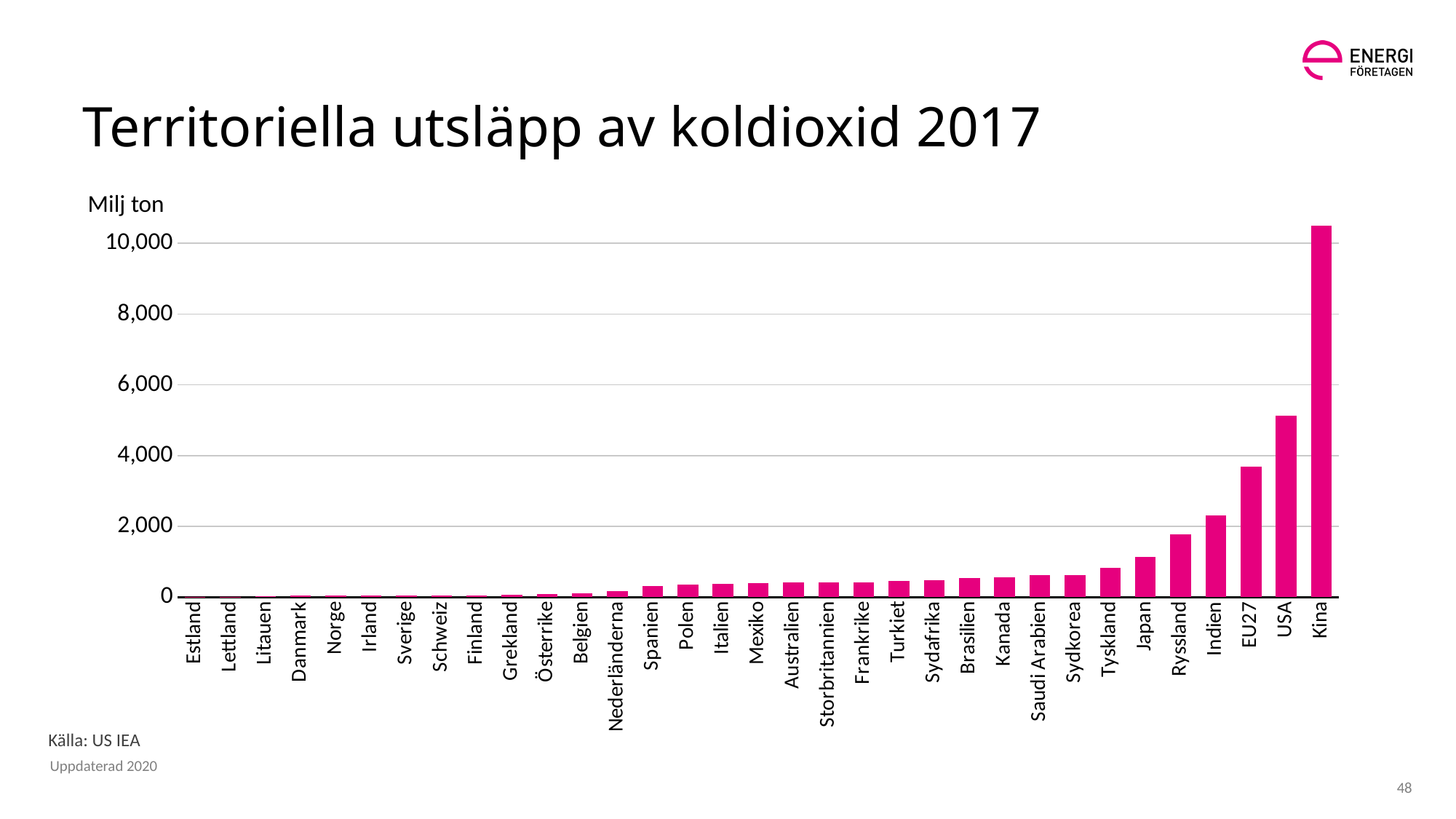
How many countries or regions are shown on the x axis? 33 Is the value for Tyskland greater or less than 1,000? less Do the bar values rise or fall from left to right along the x axis? rise Is the value for EU27 greater or less than 4,000? less Which of the two has higher emissions, USA or EU27? USA What is the title of the chart? Territoriella utsläpp av koldioxid 2017 Is the value for USA greater or less than 6,000? less What kind of chart is shown on the slide? bar chart Which country has the highest emissions in the chart? Kina What unit is shown on the y axis of the chart? Milj ton Which of the two has higher emissions, Indien or Ryssland? Indien